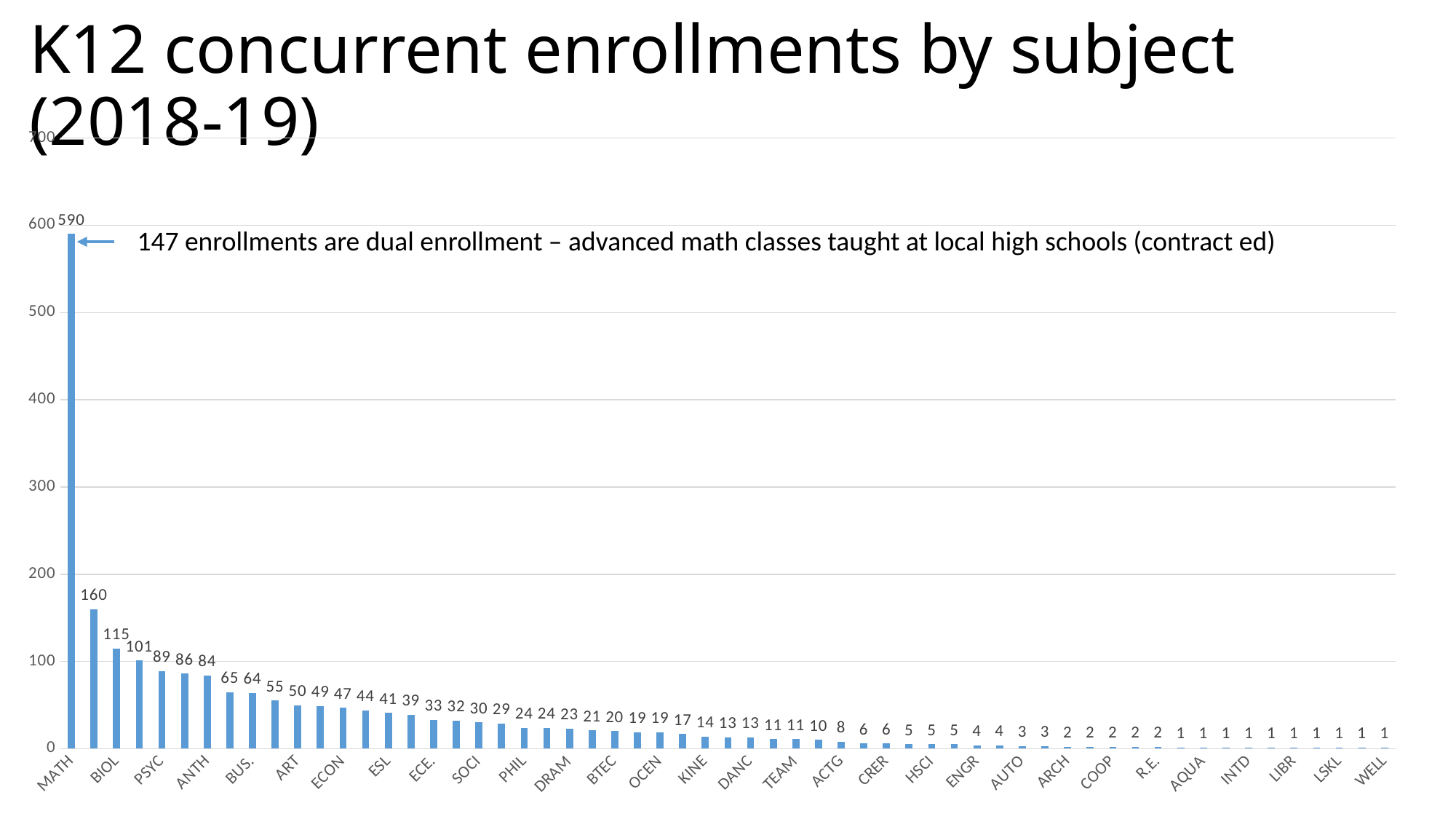
Is the value for MATH greater or less than 500? greater What is the smallest enrollment value labelled on the chart? 1 Which subject has the highest number of K12 concurrent enrollments? MATH What kind of chart is shown on the slide? bar chart What is the title of the slide? K12 concurrent enrollments by subject (2018-19) What is the second-highest enrollment value shown on the chart? 160 Which is larger, the enrollment for MATH or the bar labelled 160? MATH What is the highest value shown on the y axis? 700 How many K12 concurrent enrollments does MATH have? 590 Do the enrollment values rise or fall moving from left to right along the x axis? fall What is the difference between the highest bar (590) and the second-highest bar (160)? 430 According to the annotation, how many of the MATH enrollments are dual enrollment? 147